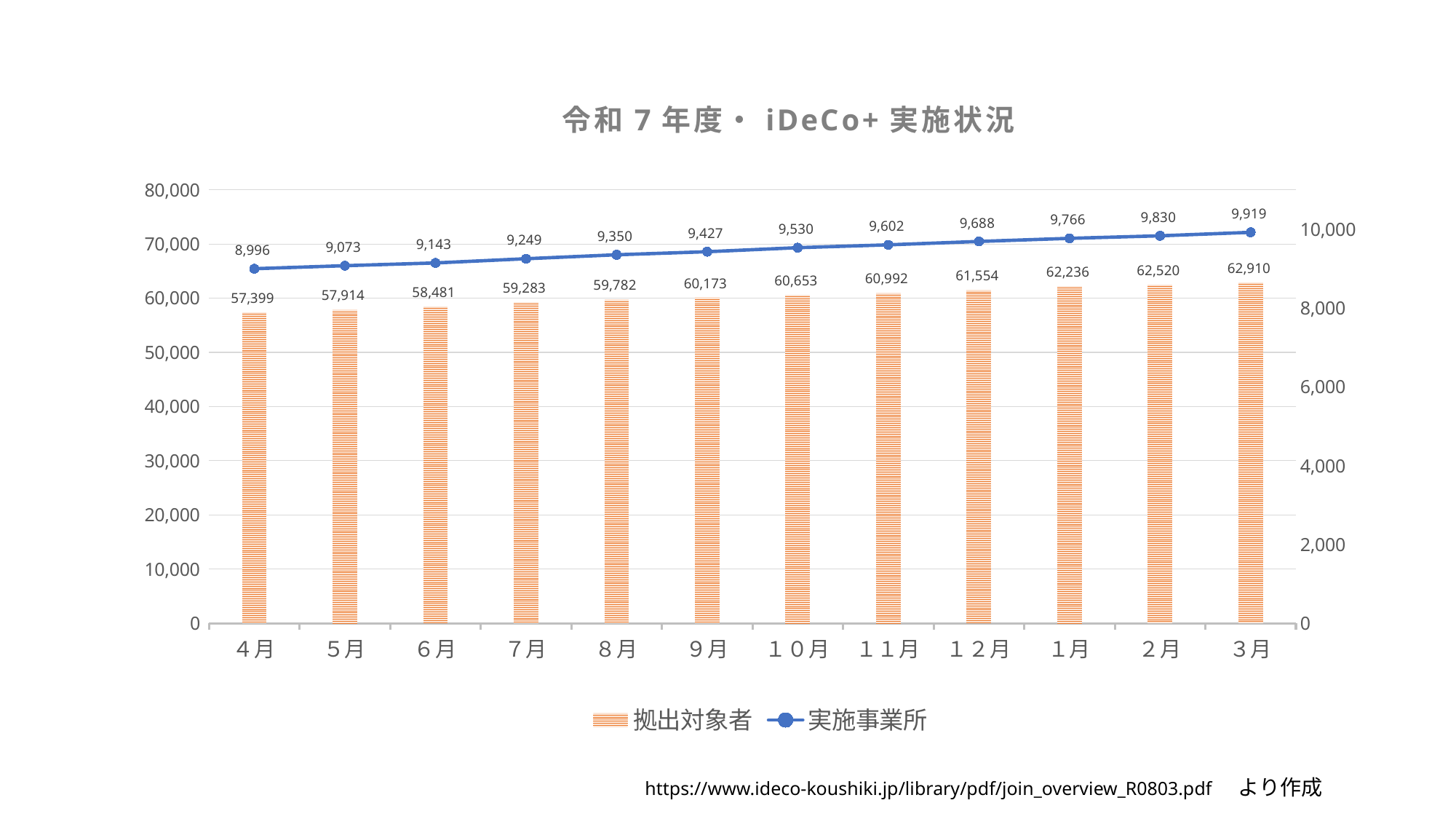
Which is larger, the 拠出対象者 value for 1月 or for 2月? 2月 Which month has the highest value for 拠出対象者? 3月 What is the difference between the 拠出対象者 values for 3月 and 4月? 5,511 Do the 実施事業所 values rise or fall from 4月 to 3月? rise What is the value of 実施事業所 for 8月? 9,350 What is the value of 拠出対象者 for 10月? 60,653 How many months are shown on the x axis? 12 What is the value of 拠出対象者 for 4月? 57,399 How many series does the legend list? 2 What is the difference between the 実施事業所 values for 12月 and 11月? 86 Which month has the lowest value for 実施事業所? 4月 What is the value of 実施事業所 for 3月? 9,919